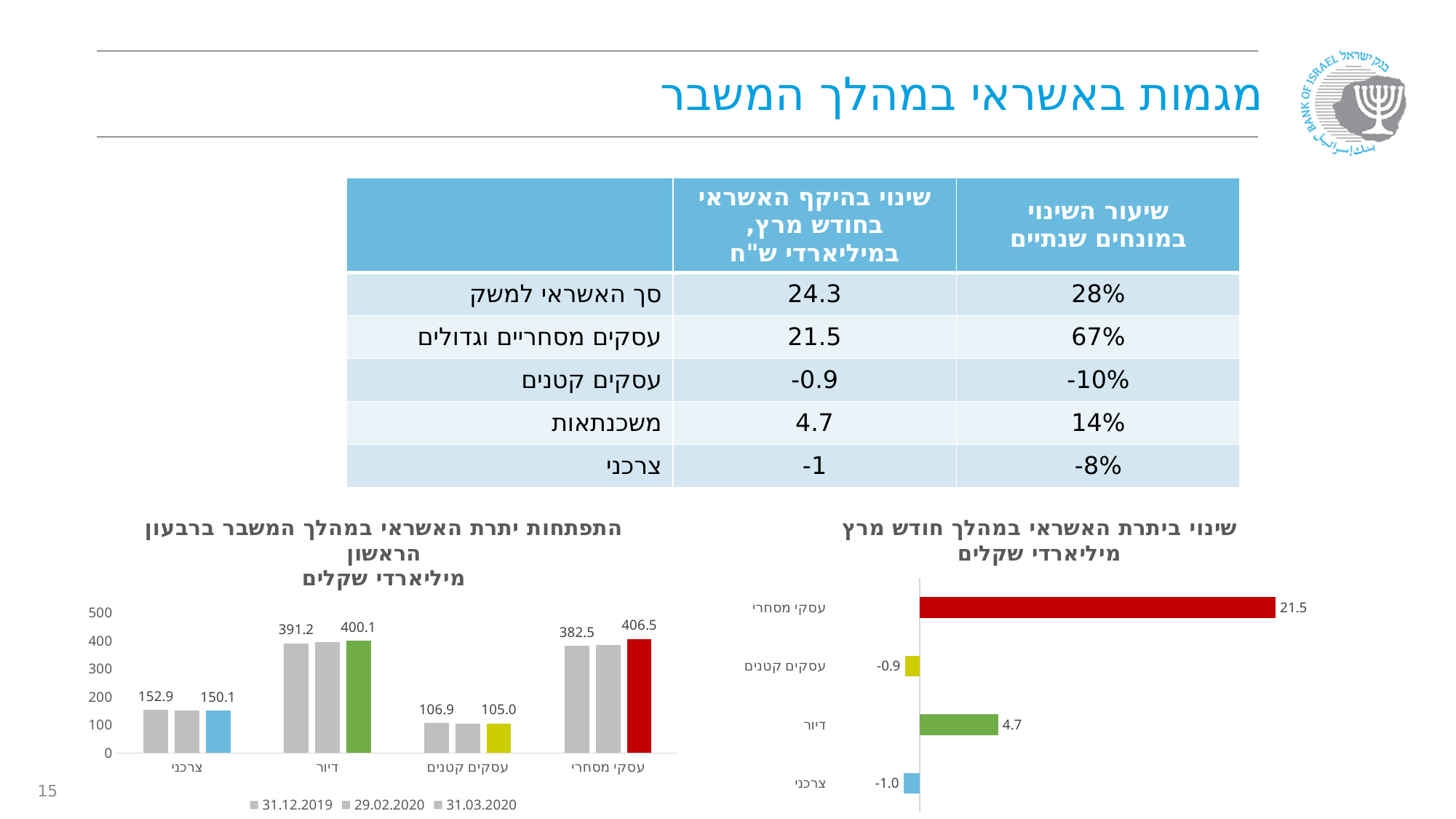
In the chart on the left (התפתחות יתרת האשראי במהלך המשבר ברבעון הראשון), how many series does the legend list? 3 In the chart on the right (שינוי ביתרת האשראי במהלך חודש מרץ), how many categories are shown? 4 In the chart on the right (שינוי ביתרת האשראי במהלך חודש מרץ), which category has the highest value? עסקי מסחרי In the chart on the left (התפתחות יתרת האשראי במהלך המשבר ברבעון הראשון), is the 31.12.2019 value for צרכני greater or less than 200? less In the chart on the left (התפתחות יתרת האשראי במהלך המשבר ברבעון הראשון), what is the value for דיור on 31.12.2019? 391.2 In the chart on the left (התפתחות יתרת האשראי במהלך המשבר ברבעון הראשון), what is the difference between the 31.03.2020 and 31.12.2019 values for עסקי מסחרי? 24.0 In the chart on the right (שינוי ביתרת האשראי במהלך חודש מרץ), which category has the lowest value? צרכני What kind of chart is the chart on the right (שינוי ביתרת האשראי במהלך חודש מרץ)? bar chart In the chart on the left (התפתחות יתרת האשראי במהלך המשבר ברבעון הראשון), which is larger on 31.03.2020: דיור or עסקים קטנים? דיור In the chart on the left (התפתחות יתרת האשראי במהלך המשבר ברבעון הראשון), what is the value for עסקי מסחרי on 31.03.2020? 406.5 In the chart on the right (שינוי ביתרת האשראי במהלך חודש מרץ), what is the value for דיור? 4.7 In the chart on the right (שינוי ביתרת האשראי במהלך חודש מרץ), what is the value for עסקי מסחרי? 21.5